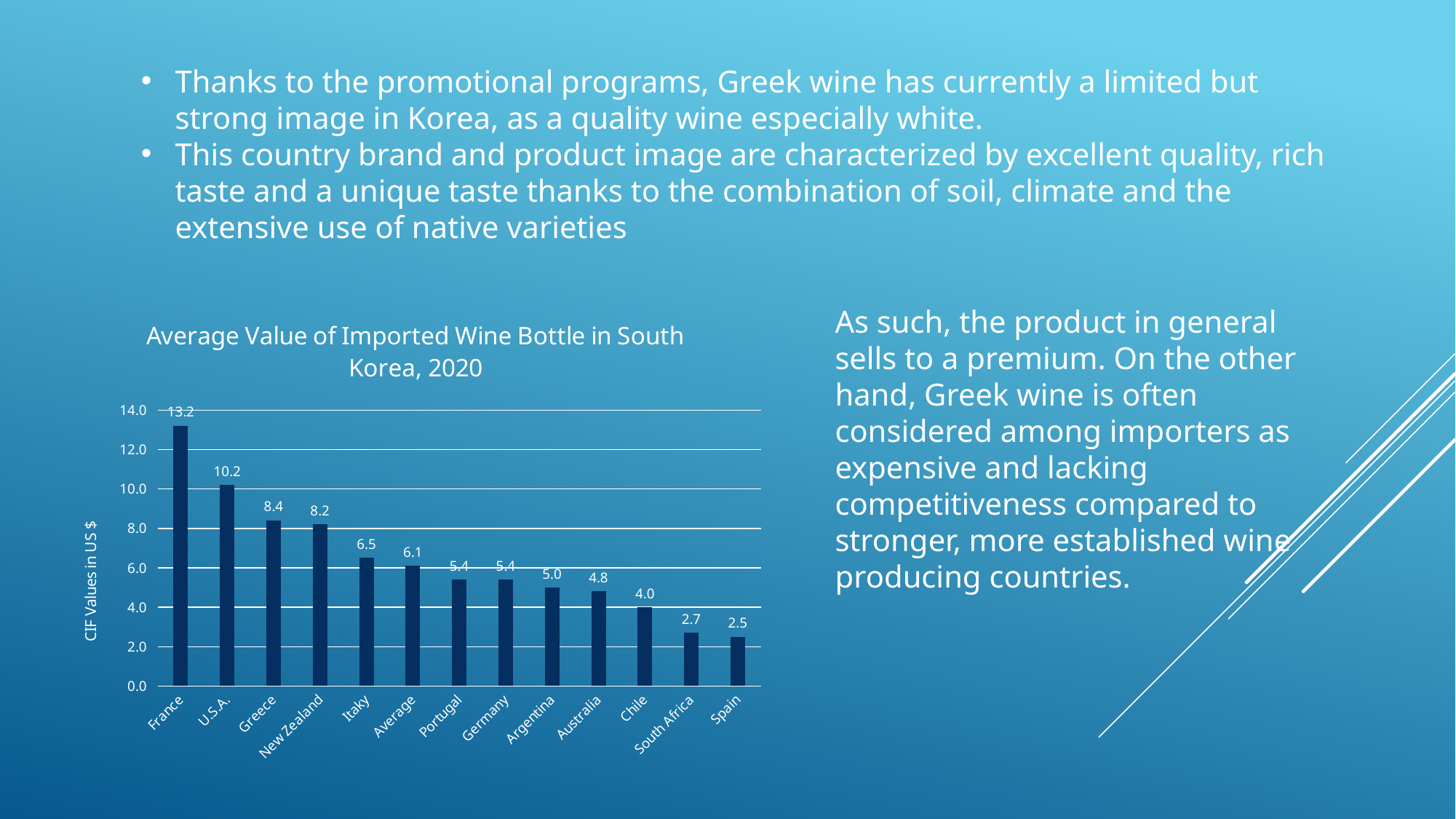
What is the value for South Africa in the chart? 2.7 Which category has the highest value in the chart? France What is the value for New Zealand in the chart? 8.2 What is the difference between the values for France and U.S.A.? 3.0 Which is larger, the value for Argentina or the value for Australia? Argentina Which category has the lowest value in the chart? Spain What is the value for Greece in the chart? 8.4 Is the value for U.S.A. greater or less than 10.0? greater What kind of chart is shown on the slide? Bar chart What is the label of the vertical axis of the chart? CIF Values in US $ What is the difference between the values for Greece and Chile? 4.4 How many categories are shown on the x axis of the chart? 13